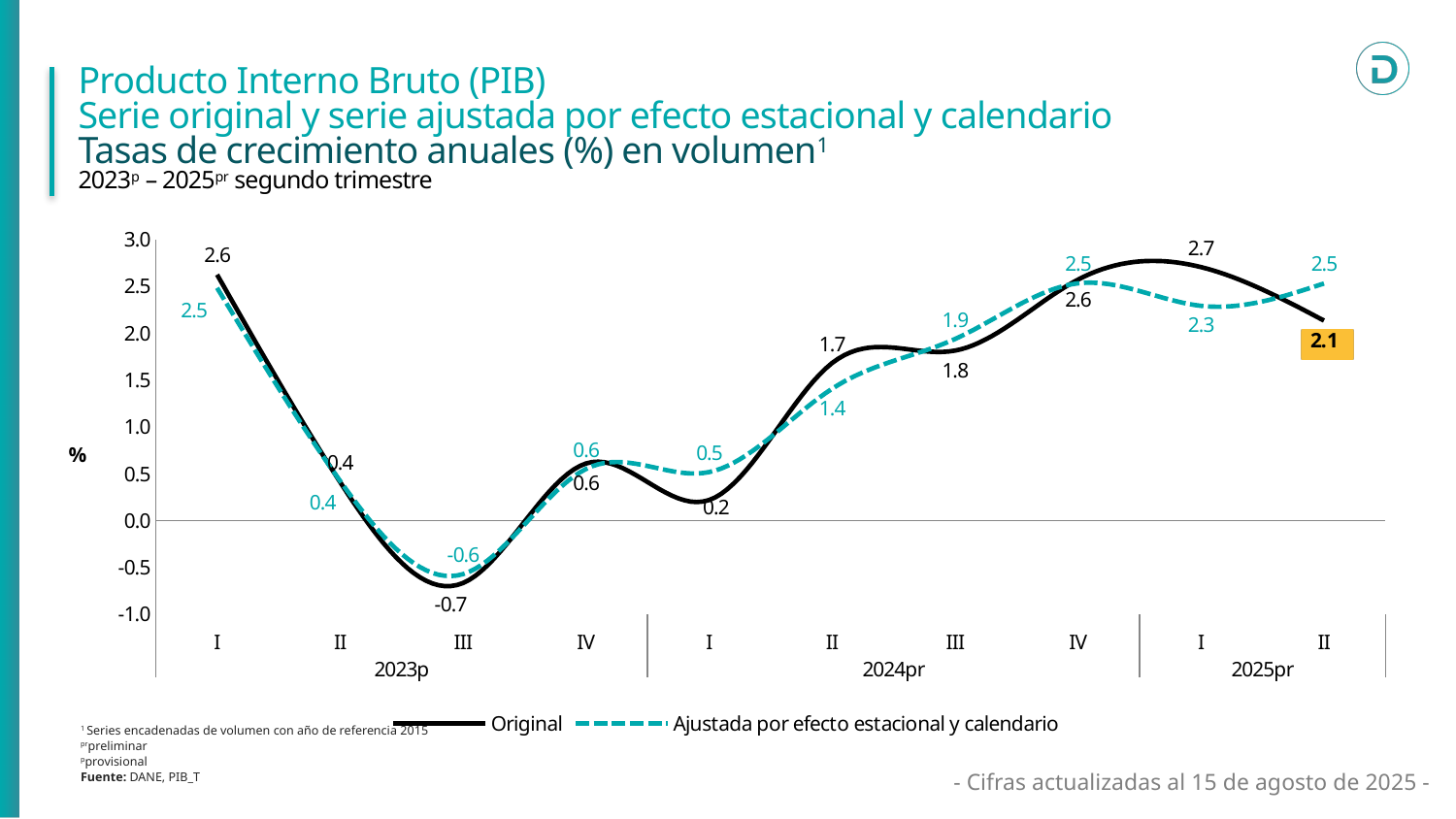
What is the difference between the Original and the Ajustada values in quarter II of 2025pr? 0.4 In which quarter does the Original series reach its lowest value? III 2023p What kind of chart is shown on the slide? Line chart What is the value of the Original series for quarter II of 2025pr? 2.1 In which quarter does the Original series reach its highest value? I 2025pr Does the Original series rise or fall from quarter I of 2025pr to quarter II of 2025pr? Fall How many quarters are plotted on the x axis? 10 How many series does the legend list? 2 In quarter II of 2024pr, which series has the larger value, Original or Ajustada por efecto estacional y calendario? Original Which series is drawn with a dashed line? Ajustada por efecto estacional y calendario What is the value of the Original series for quarter I of 2024pr? 0.2 What is the value of the Ajustada por efecto estacional y calendario series for quarter III of 2023p? -0.6